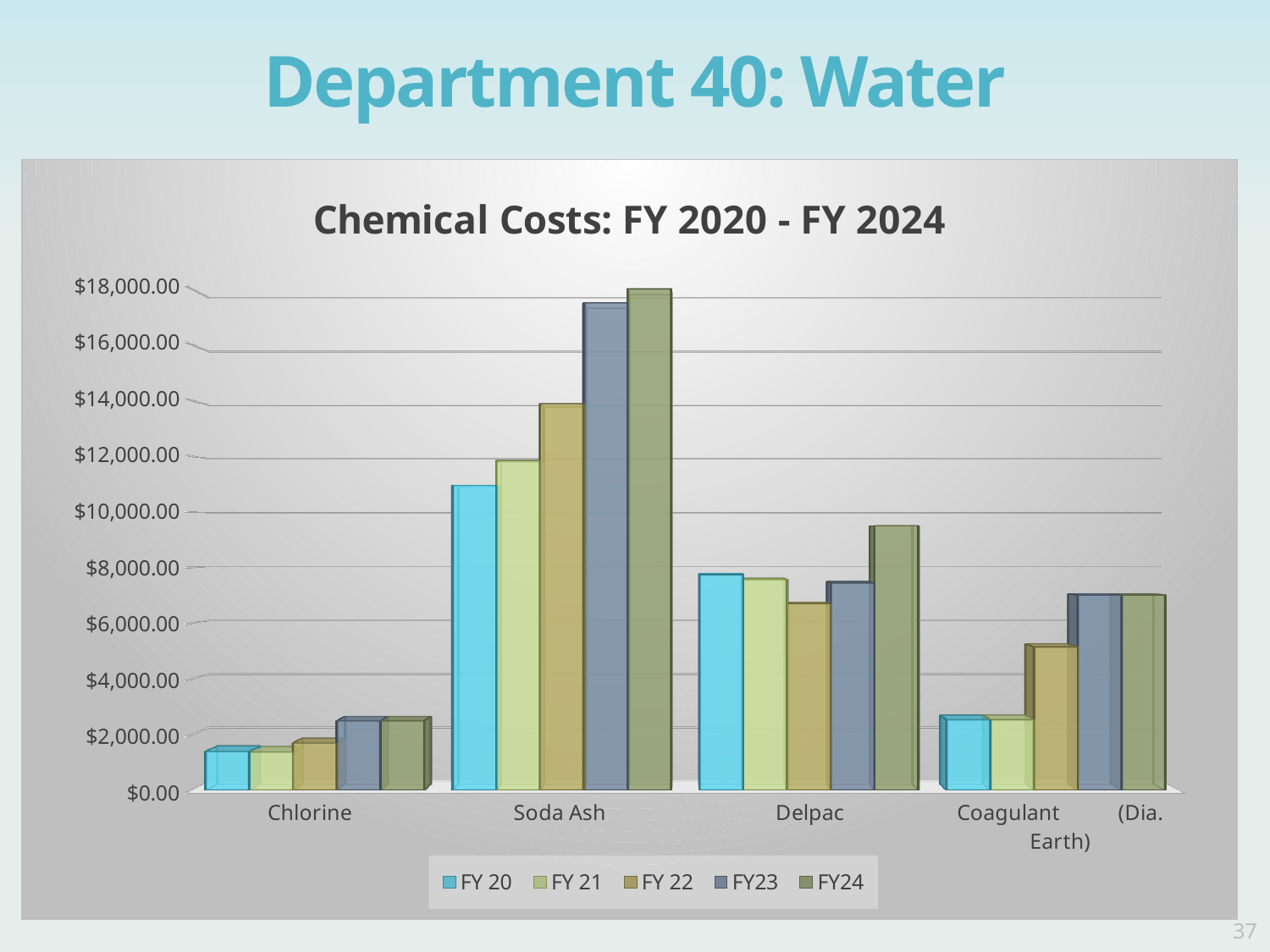
For Delpac, which is larger, the FY 22 cost or the FY24 cost? FY24 Is the FY23 value for Coagulant (Dia. Earth) greater or less than $6,000.00? greater What kind of chart is shown on the slide? bar chart Is the FY24 value for Soda Ash greater or less than $16,000.00? greater Is the FY 22 value for Delpac greater or less than $8,000.00? less How many series does the legend list? 5 Which chemical has the highest FY24 cost? Soda Ash Which chemical has the lowest FY 20 cost? Chlorine What is the title of the chart? Chemical Costs: FY 2020 - FY 2024 How many chemical categories are shown on the x axis? 4 Do the Soda Ash costs rise or fall from FY 20 to FY24? rise Which is larger, the FY 20 cost for Soda Ash or the FY 20 cost for Delpac? Soda Ash